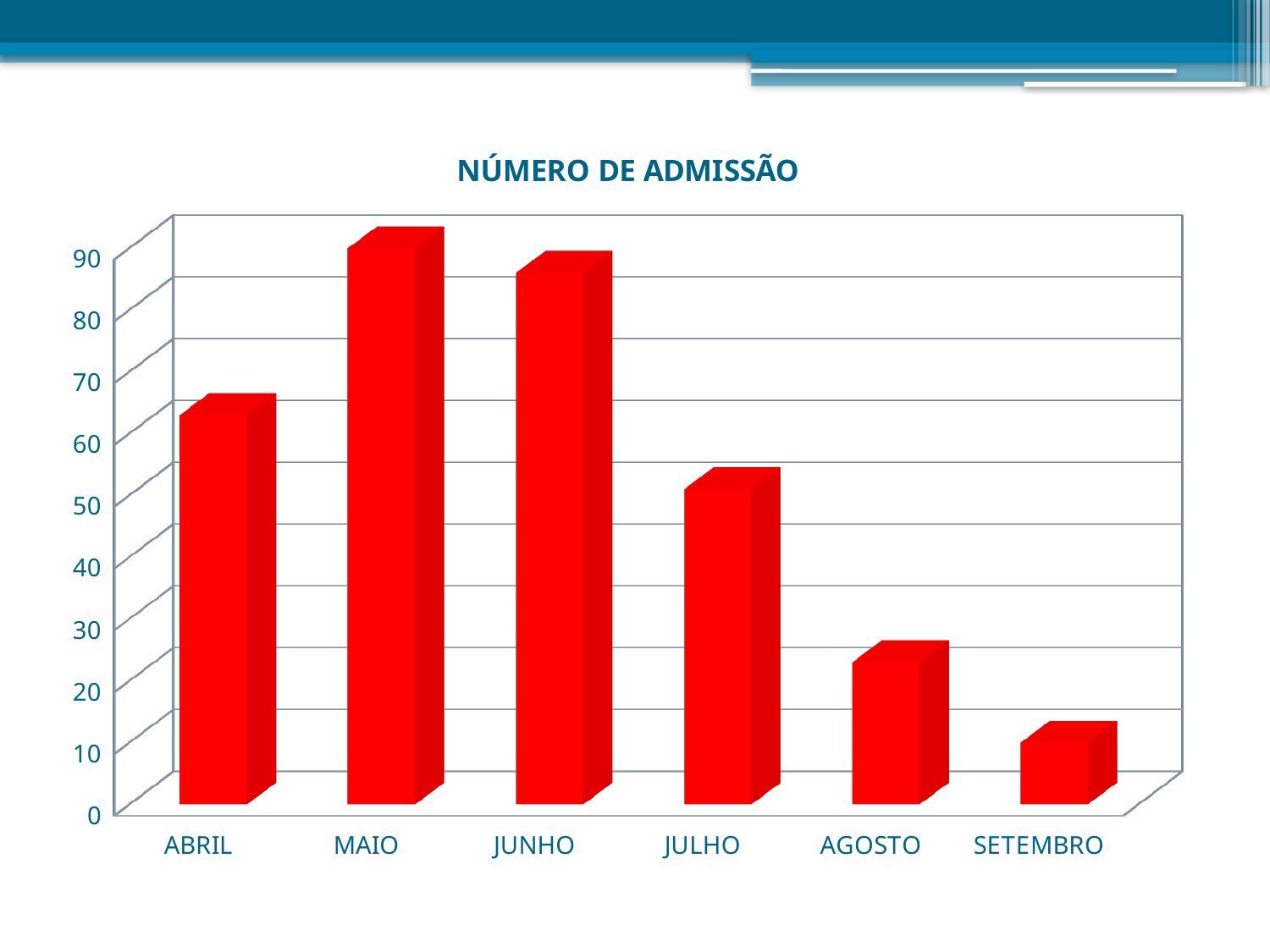
What is the title of the chart? NÚMERO DE ADMISSÃO Is the value for MAIO greater or less than 80? greater Is the value for JULHO greater or less than 60? less Which month has the highest number of admissions? MAIO Is the value for ABRIL greater or less than 50? greater What kind of chart is shown on the slide? bar chart Which month has a larger value, ABRIL or JULHO? ABRIL Which month has the lowest number of admissions? SETEMBRO Do the values rise or fall from JUNHO to SETEMBRO? fall How many months are shown on the x axis of the chart? 6